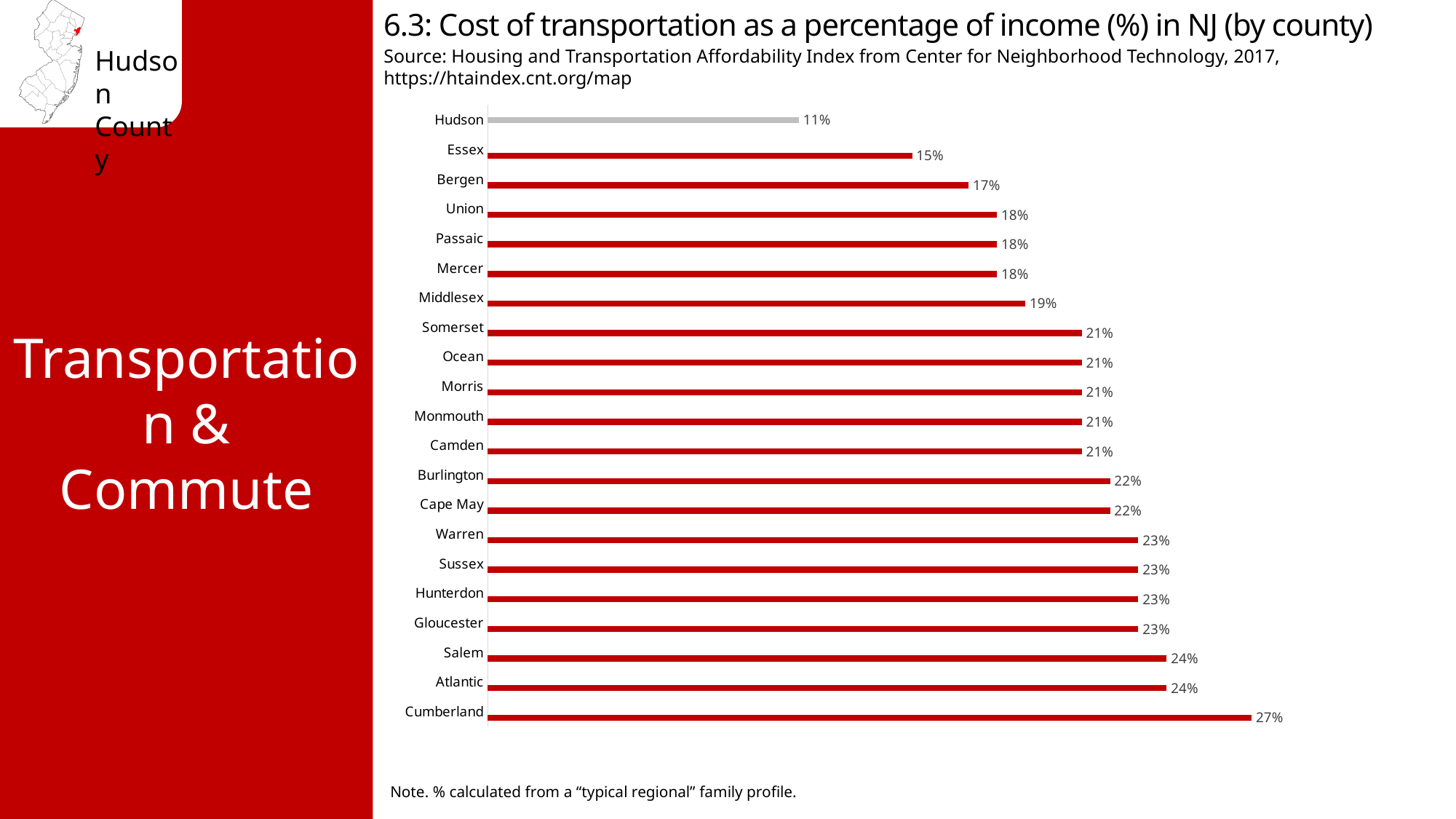
Which county's bar is shown in a different colour (grey) from the others? Hudson What is the difference between the values for Cumberland and Hudson? 16% Which county has the lowest cost of transportation as a percentage of income? Hudson How many counties are shown in the chart? 21 What type of chart is shown on the slide? Bar chart What is the difference between the values for Bergen and Essex? 2% What is the cost of transportation as a percentage of income for Hudson County? 11% Which has a higher value, Salem or Warren? Salem Which county has the highest cost of transportation as a percentage of income? Cumberland What is the value shown for Essex County? 15% What is the value shown for Middlesex County? 19% What is the value shown for Cumberland County? 27%